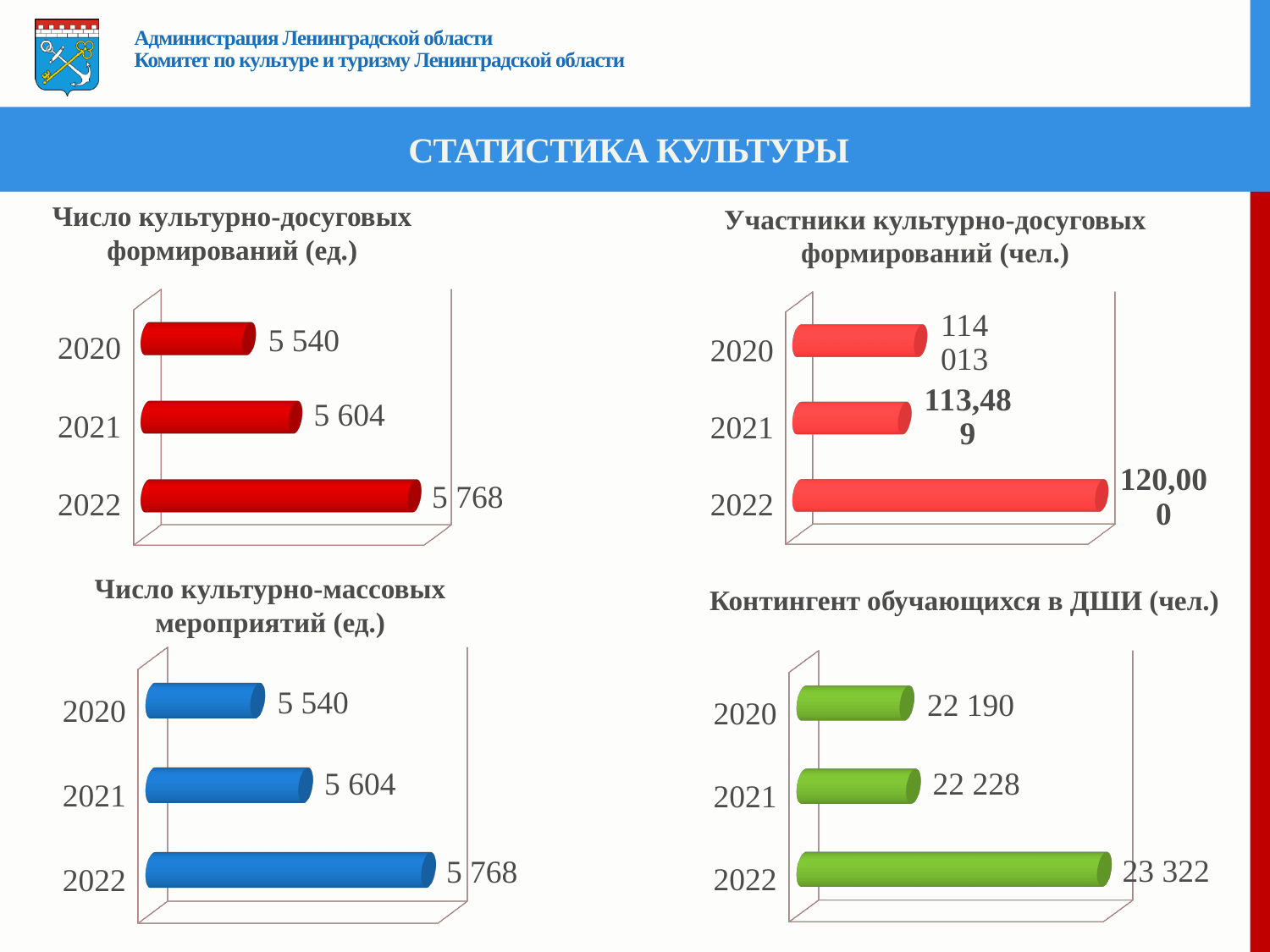
In the chart 'Число культурно-досуговых формирований (ед.)', what is the difference between the 2022 and 2020 values? 228 In the chart 'Число культурно-досуговых формирований (ед.)', what is the value for 2020? 5 540 In the chart 'Участники культурно-досуговых формирований (чел.)', which year has the highest value? 2022 In the chart 'Участники культурно-досуговых формирований (чел.)', which year has the lowest value? 2021 What type of chart is 'Контингент обучающихся в ДШИ (чел.)'? bar chart In the chart 'Контингент обучающихся в ДШИ (чел.)', what is the difference between the 2021 and 2020 values? 38 How many years are shown in the chart 'Контингент обучающихся в ДШИ (чел.)'? 3 In the chart 'Число культурно-досуговых формирований (ед.)', what is the value for 2022? 5 768 In the chart 'Контингент обучающихся в ДШИ (чел.)', what is the value for 2022? 23 322 In the chart 'Число культурно-массовых мероприятий (ед.)', do the values rise or fall from 2020 to 2022? rise In the chart 'Число культурно-массовых мероприятий (ед.)', what is the value for 2021? 5 604 In the chart 'Контингент обучающихся в ДШИ (чел.)', what is the value for 2020? 22 190